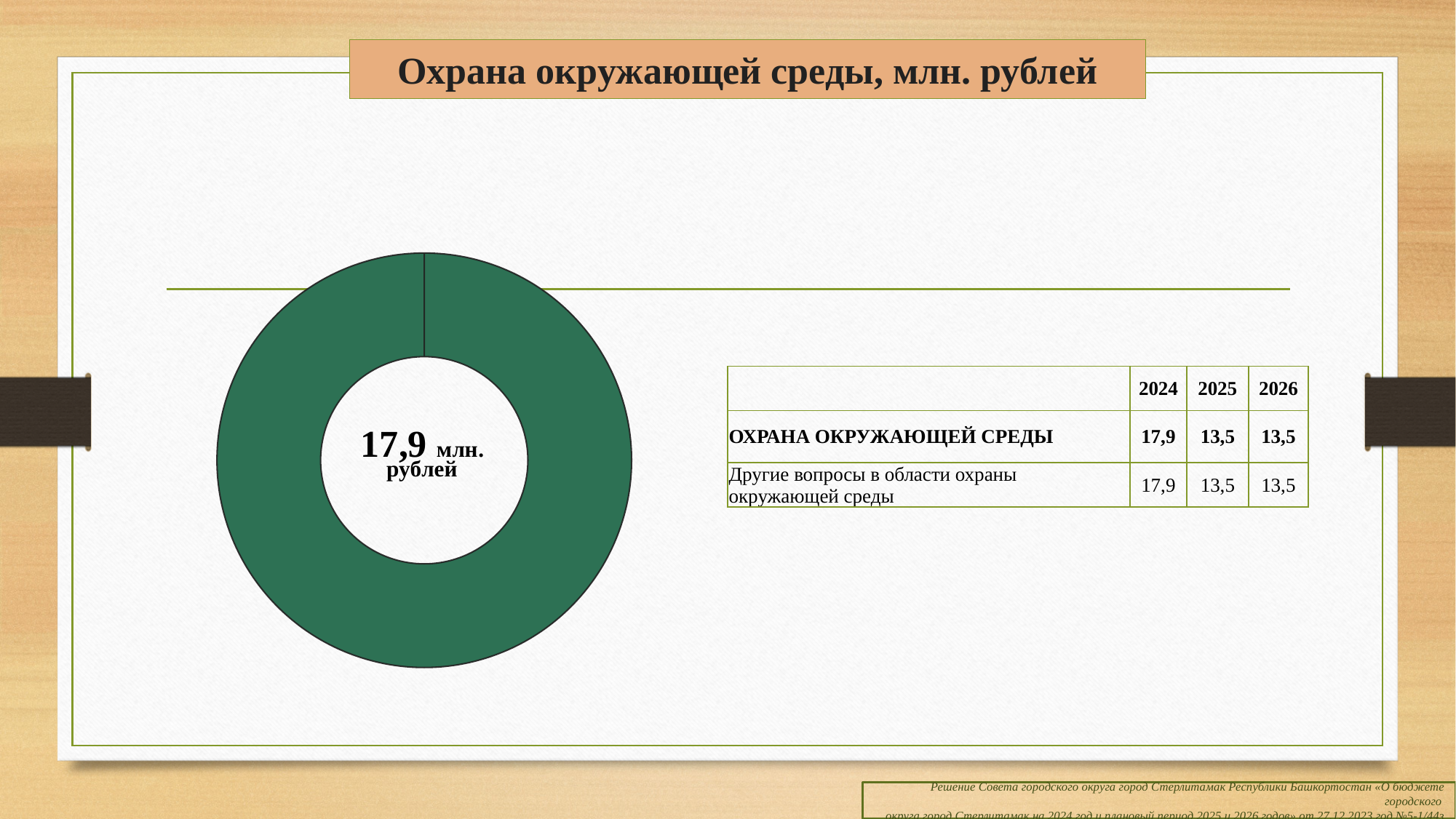
What value is printed in the centre of the doughnut chart? 17,9 млн. рублей What is the title shown above the doughnut chart on the slide? Охрана окружающей среды, млн. рублей How many slices does the doughnut chart contain? 1 What colour is the ring of the doughnut chart? green Does the doughnut chart display a legend? No What kind of chart is shown on the slide? doughnut chart